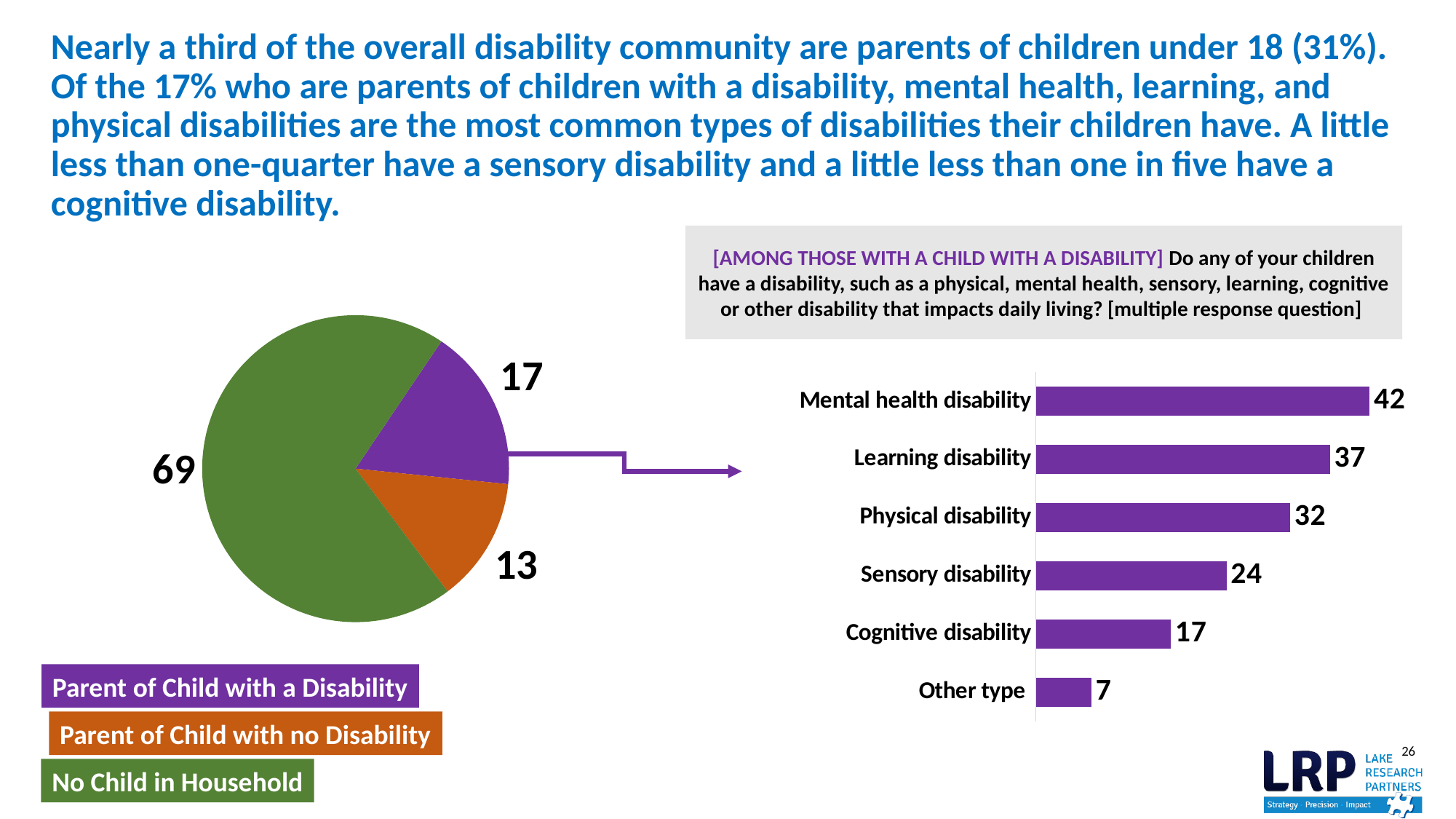
In the pie chart on the left, what is the difference between No Child in Household and Parent of Child with no Disability? 56 In the bar chart on the right, what is the value for Mental health disability? 42 In the bar chart on the right, which category has the lowest value? Other type In the bar chart on the right, which category has the highest value? Mental health disability In the bar chart on the right, which is larger: Cognitive disability or Sensory disability? Sensory disability How many categories are shown in the bar chart on the right? 6 In the bar chart on the right, what is the value for Sensory disability? 24 What kind of chart is on the right side of the slide? Bar chart In the pie chart on the left, what colour is the slice for Parent of Child with no Disability? Orange In the bar chart on the right, what is the difference between Learning disability and Physical disability? 5 In the pie chart on the left, what is the value for Parent of Child with a Disability? 17 In the pie chart on the left, which slice is the largest? No Child in Household